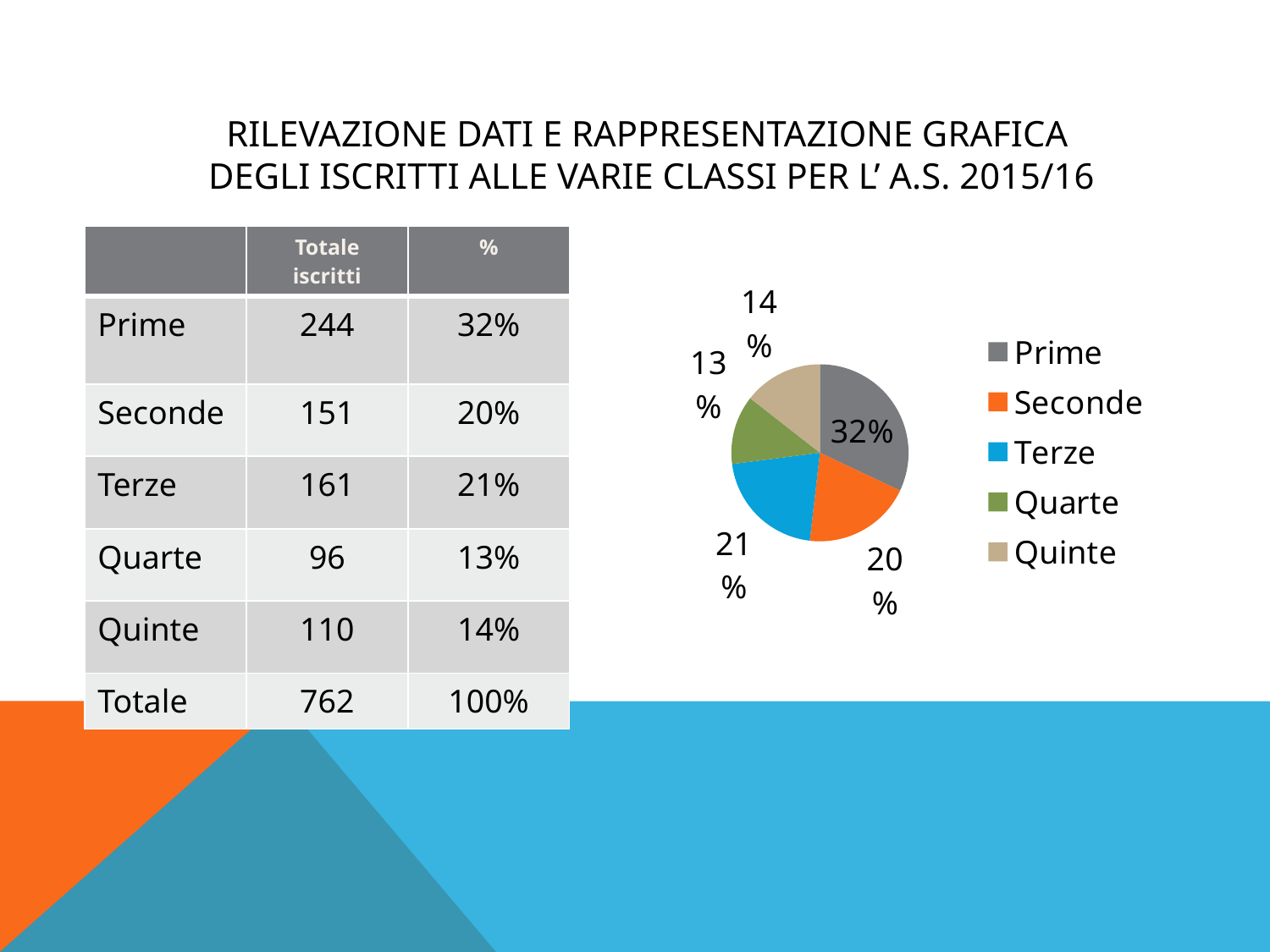
What share of the pie does the Quarte slice represent? 13% Which slice of the pie chart is the smallest? Quarte What is the difference in percentage points between the Prime slice and the Seconde slice? 12 What share of the pie does the Terze slice represent? 21% How many slices does the pie chart have? 5 Which colour is used for the Terze slice in the pie chart? blue What share of the pie does the Seconde slice represent? 20% Which slice of the pie chart is the largest? Prime What kind of chart is shown on the slide? pie chart How many entries does the pie chart's legend list? 5